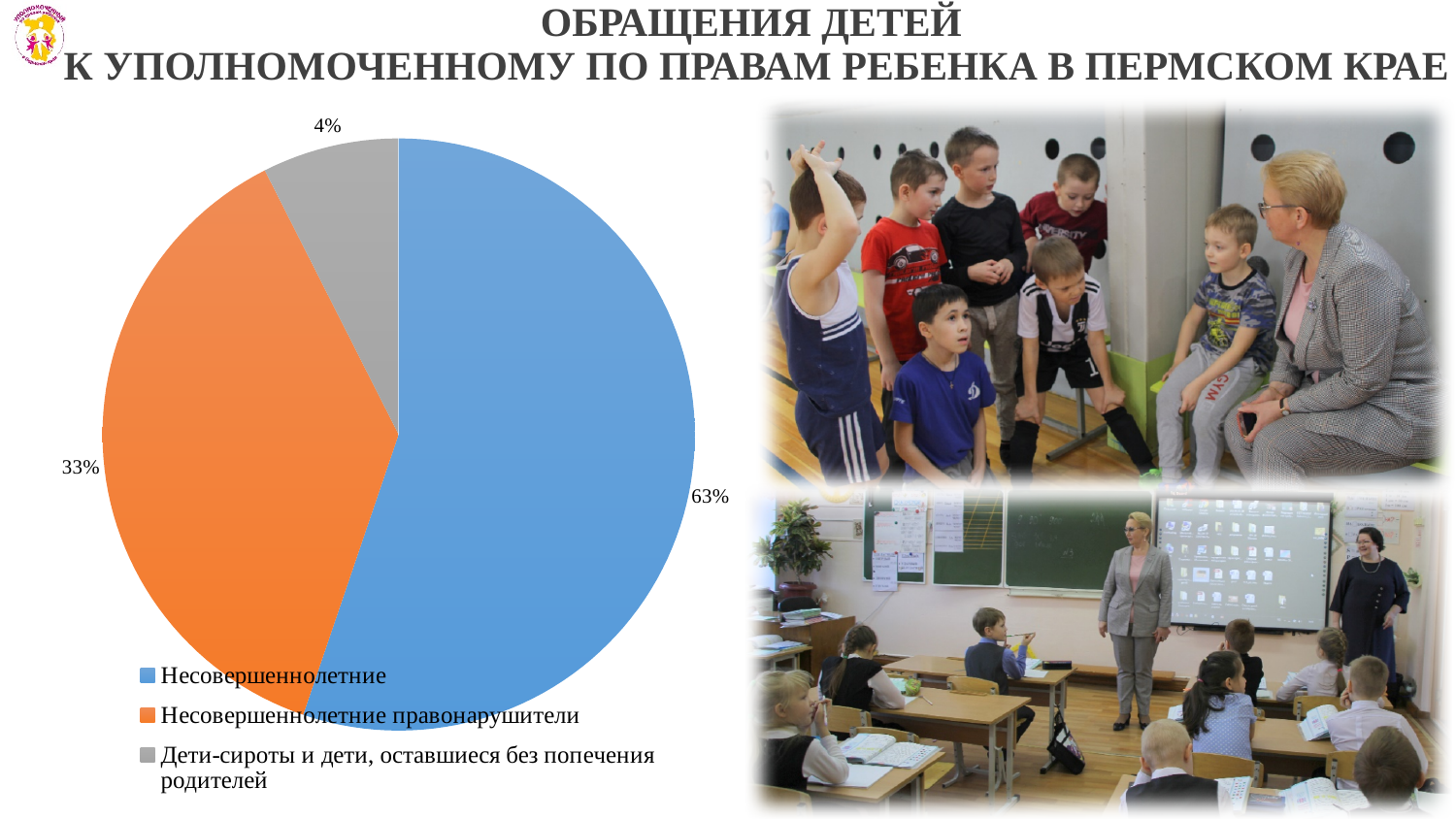
What share of the pie does the category "Несовершеннолетние правонарушители" have? 33% What kind of chart is shown on the slide? pie chart What colour is the slice for "Несовершеннолетние правонарушители"? orange Which category has the largest share of the pie? Несовершеннолетние How many categories does the pie chart have? 3 Which is larger: the share of "Несовершеннолетние правонарушители" or the share of "Дети-сироты и дети, оставшиеся без попечения родителей"? Несовершеннолетние правонарушители What colour is the slice for "Несовершеннолетние"? blue What is the difference in percentage points between the shares of "Несовершеннолетние" and "Несовершеннолетние правонарушители"? 30 What share of the pie does the category "Дети-сироты и дети, оставшиеся без попечения родителей" have? 4% Which category has the smallest share of the pie? Дети-сироты и дети, оставшиеся без попечения родителей How many entries does the legend list? 3 What share of the pie does the category "Несовершеннолетние" have? 63%